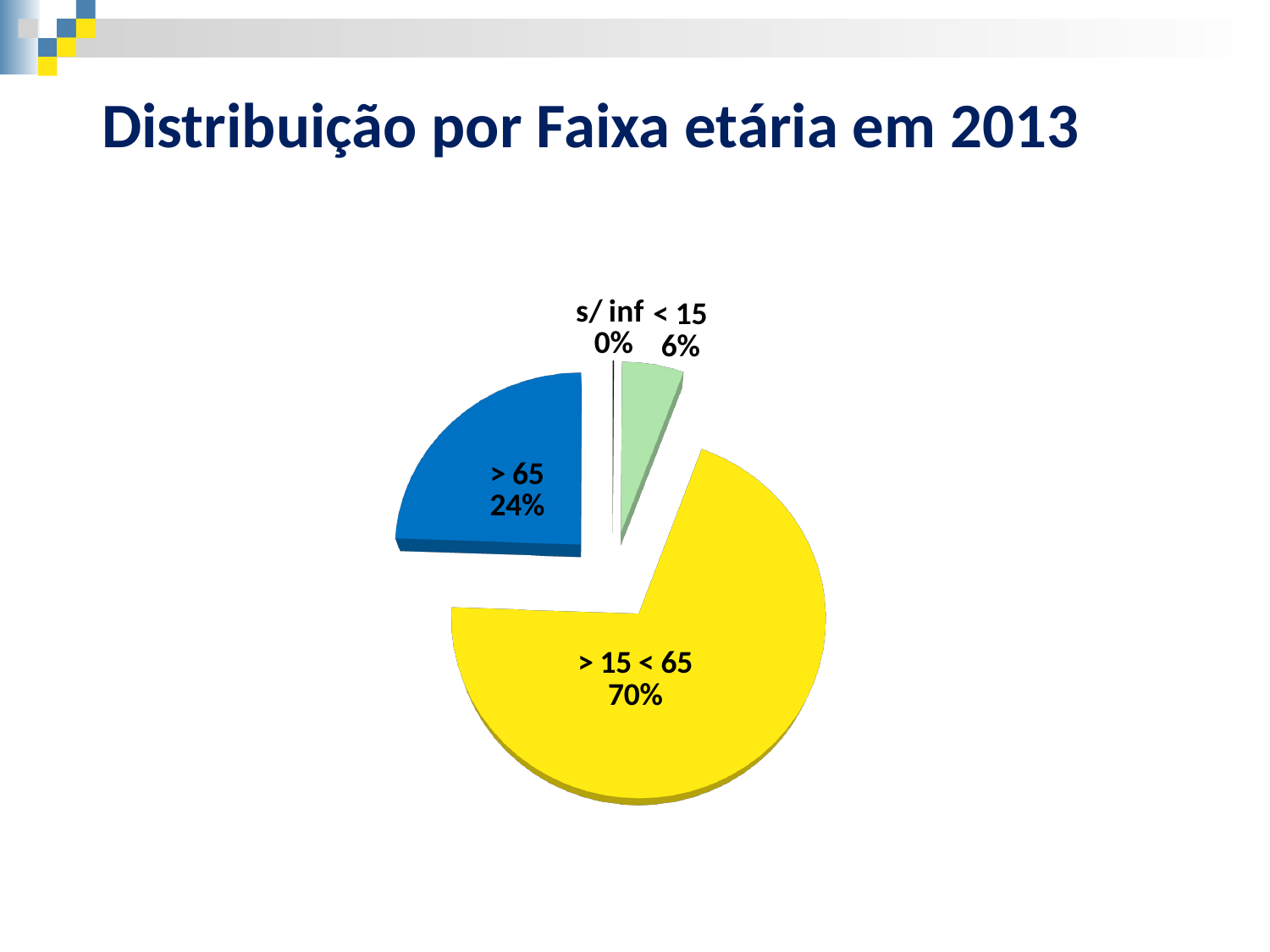
What is the difference in percentage points between the "> 15 < 65" slice and the "> 65" slice? 46 Which category has the smallest share of the pie? s/ inf What share of the pie does the "> 15 < 65" slice represent? 70% What is the title of the slide containing the chart? Distribuição por Faixa etária em 2013 What share of the pie does the "< 15" slice represent? 6% What is the difference in percentage points between the "> 65" slice and the "< 15" slice? 18 How many slices does the pie chart have? 4 Which age group has the largest share of the pie? > 15 < 65 What share of the pie does the "s/ inf" slice represent? 0% Which is larger, the share for "> 65" or the share for "< 15"? > 65 What kind of chart is shown on the slide? Pie chart